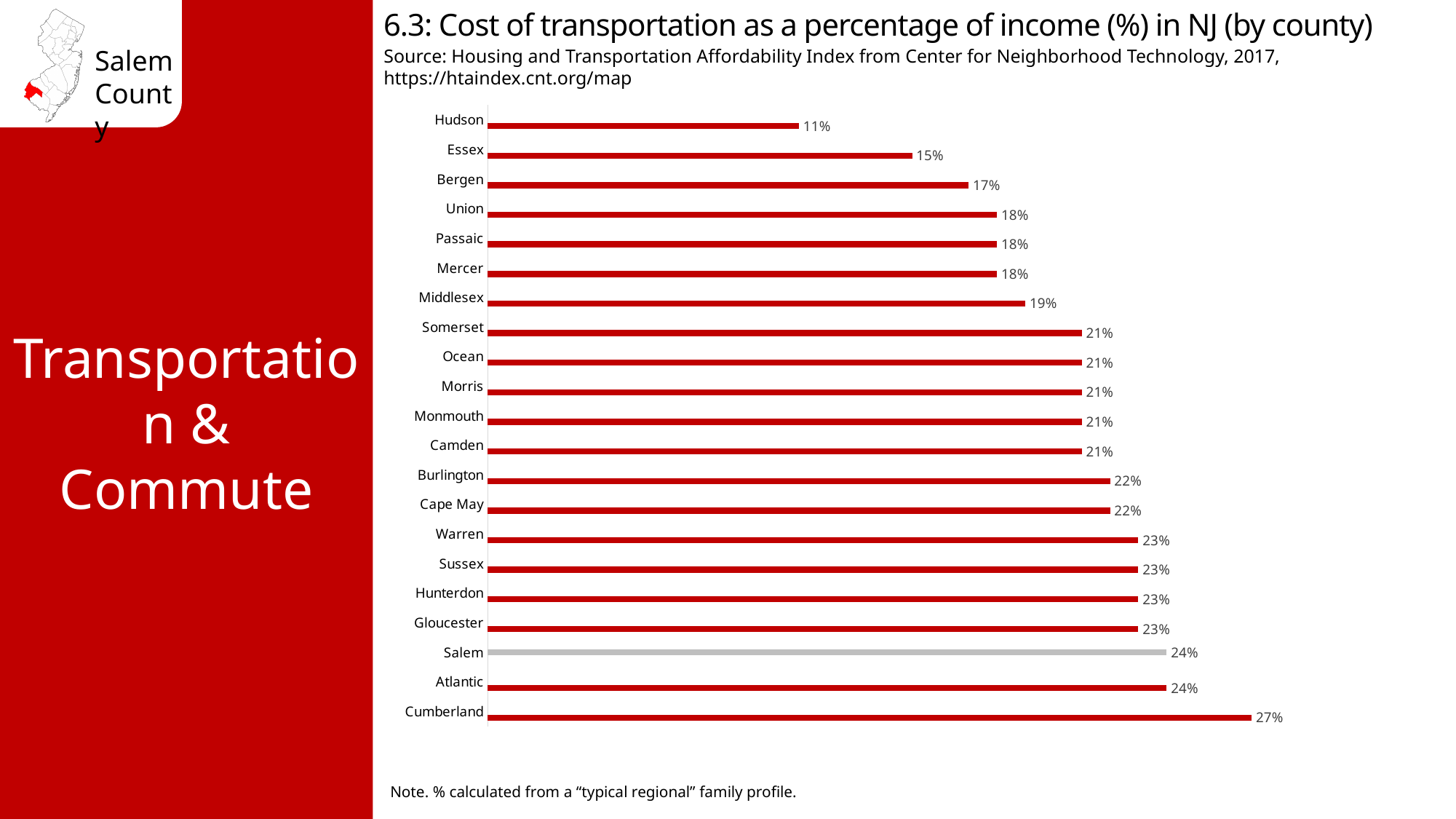
What is the value shown for Hudson county? 11% What is the cost of transportation as a percentage of income for Salem county? 24% What is the difference between the values for Cumberland and Hudson? 16% Which county has the lowest cost of transportation as a percentage of income? Hudson Which county has the highest cost of transportation as a percentage of income? Cumberland Which county's bar is shown in a different colour (grey) from the others? Salem Which has a higher value, Bergen or Gloucester? Gloucester What kind of chart is shown on the slide? Bar chart What is the value shown for Middlesex county? 19% How many counties are shown in the chart? 21 What is the difference between the values for Salem and Essex? 9%